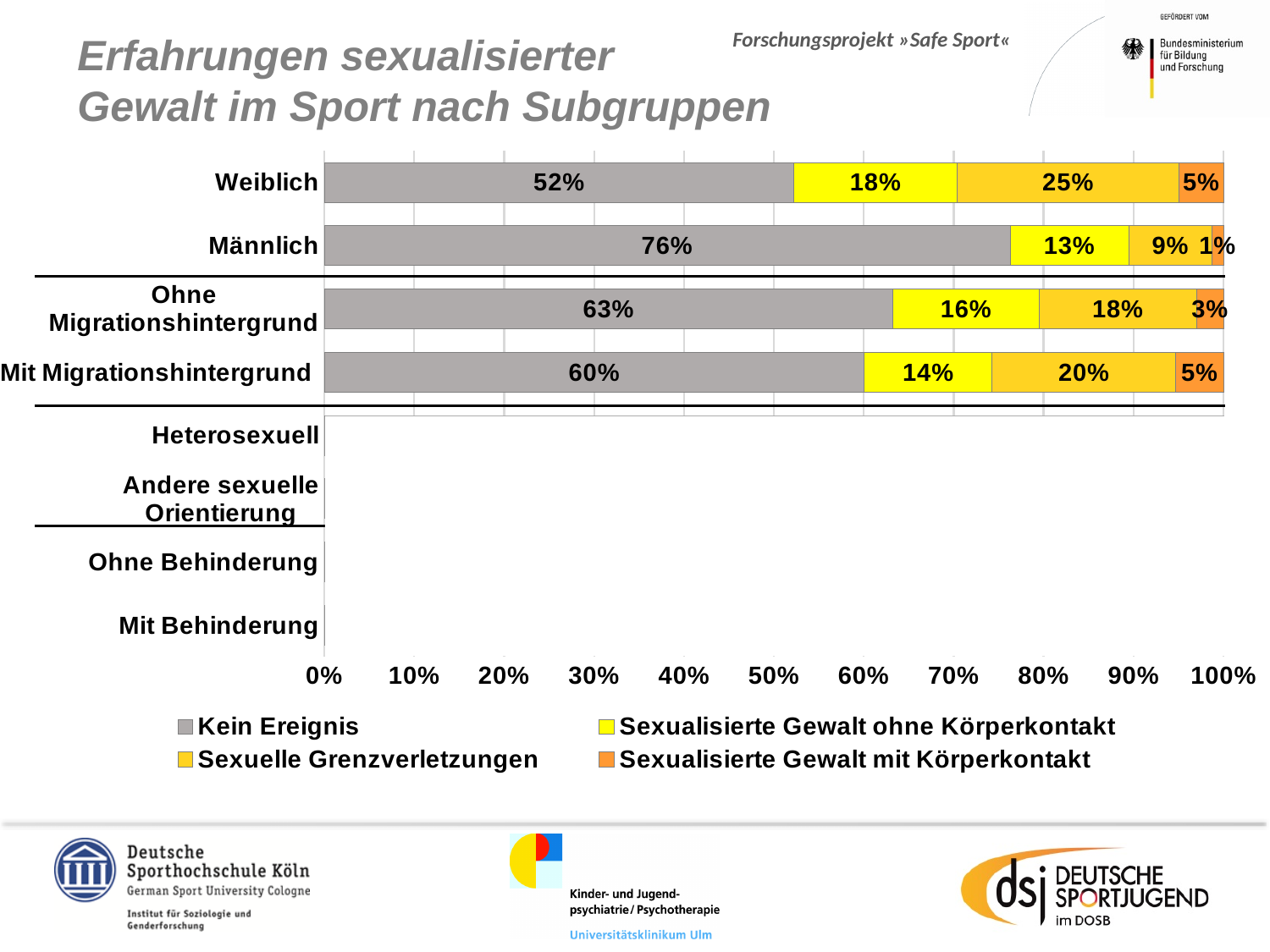
What is the total of the stacked bar for Weiblich? 100% Which subgroup has the highest value for Kein Ereignis? Männlich What is the value of Sexualisierte Gewalt mit Körperkontakt for Mit Migrationshintergrund? 5% Which has the larger Kein Ereignis value, Ohne Migrationshintergrund or Mit Migrationshintergrund? Ohne Migrationshintergrund What is the value of Sexualisierte Gewalt mit Körperkontakt for Männlich? 1% What is the difference between the Kein Ereignis values for Männlich and Weiblich? 24 percentage points How many subgroups have bars plotted in the chart? 4 What kind of chart is shown on the slide? Stacked bar chart What is the value of Kein Ereignis for Weiblich? 52% How many series does the legend list? 4 What is the value of Kein Ereignis for Männlich? 76% Which subgroup has the lowest value for Kein Ereignis? Weiblich